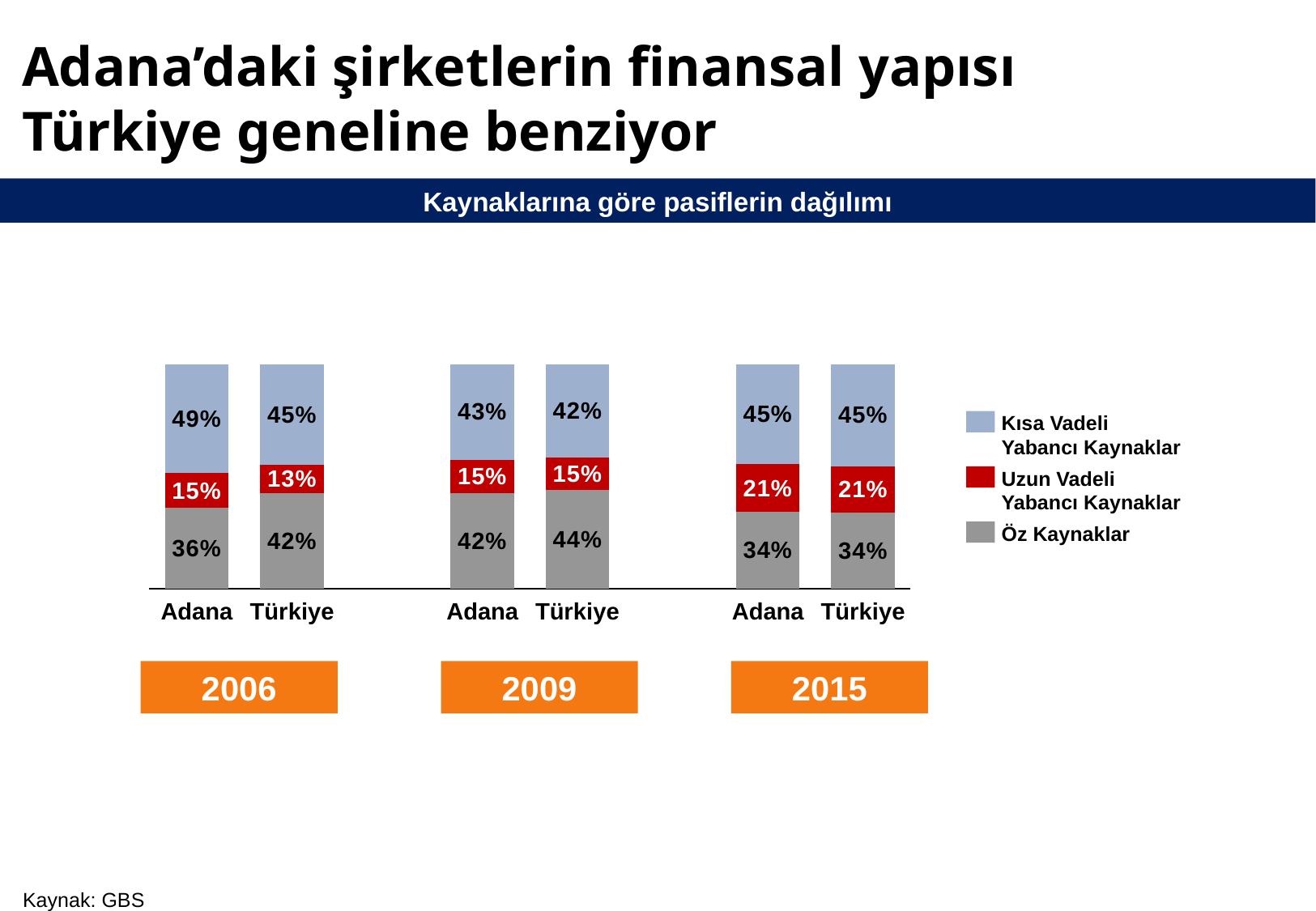
Which is larger in 2009: the Öz Kaynaklar share for Adana or for Türkiye? Türkiye What is the Uzun Vadeli Yabancı Kaynaklar share for Adana in 2015? 21% What is the difference between the Öz Kaynaklar share for Türkiye and for Adana in 2006? 6% How does the Uzun Vadeli Yabancı Kaynaklar share for Adana change from 2006 to 2015? It rises What is the Uzun Vadeli Yabancı Kaynaklar share for Türkiye in 2006? 13% How many series does the legend list? 3 Which bar has the lowest Uzun Vadeli Yabancı Kaynaklar share? Türkiye 2006 What is the Kısa Vadeli Yabancı Kaynaklar share for Türkiye in 2009? 42% What kind of chart is shown on the slide? Stacked bar chart What is the Öz Kaynaklar share for Adana in 2006? 36% Which bar has the highest Kısa Vadeli Yabancı Kaynaklar share? Adana 2006 What is the title of the chart? Kaynaklarına göre pasiflerin dağılımı